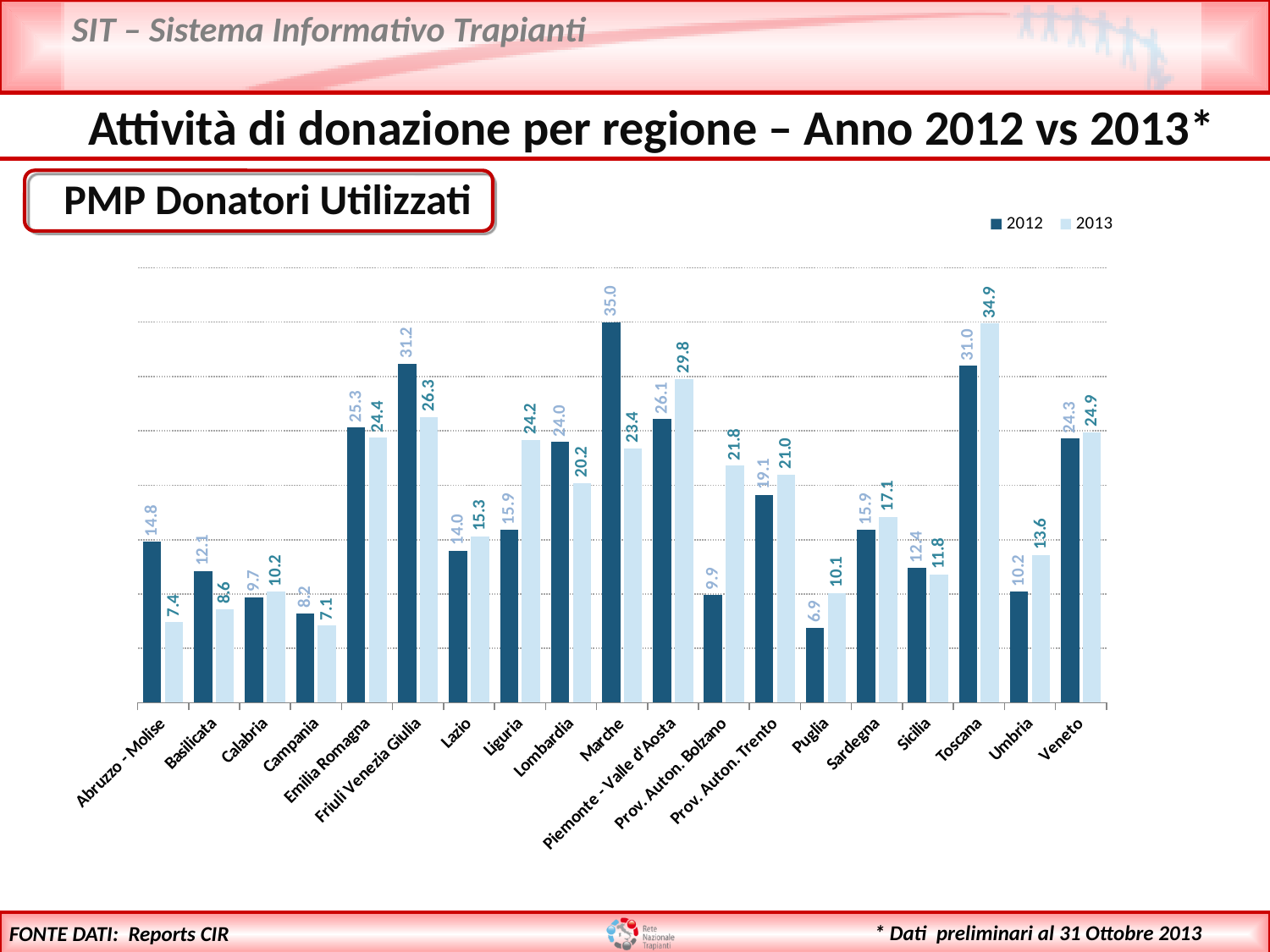
How many series does the legend list? 2 What is the 2013 value for Toscana? 34.9 Which region has the lowest 2012 value? Puglia What kind of chart is shown? Bar chart What is the 2013 value for Prov. Auton. Bolzano? 21.8 Which region has the highest 2013 value? Toscana What is the difference between the 2012 and 2013 values for Marche? 11.6 What are the two series named in the legend? 2012 and 2013 What is the 2012 value for Marche? 35.0 Which region has the highest 2012 value? Marche How many regions are shown on the x axis? 19 Which is larger for Liguria, the 2012 value or the 2013 value? 2013